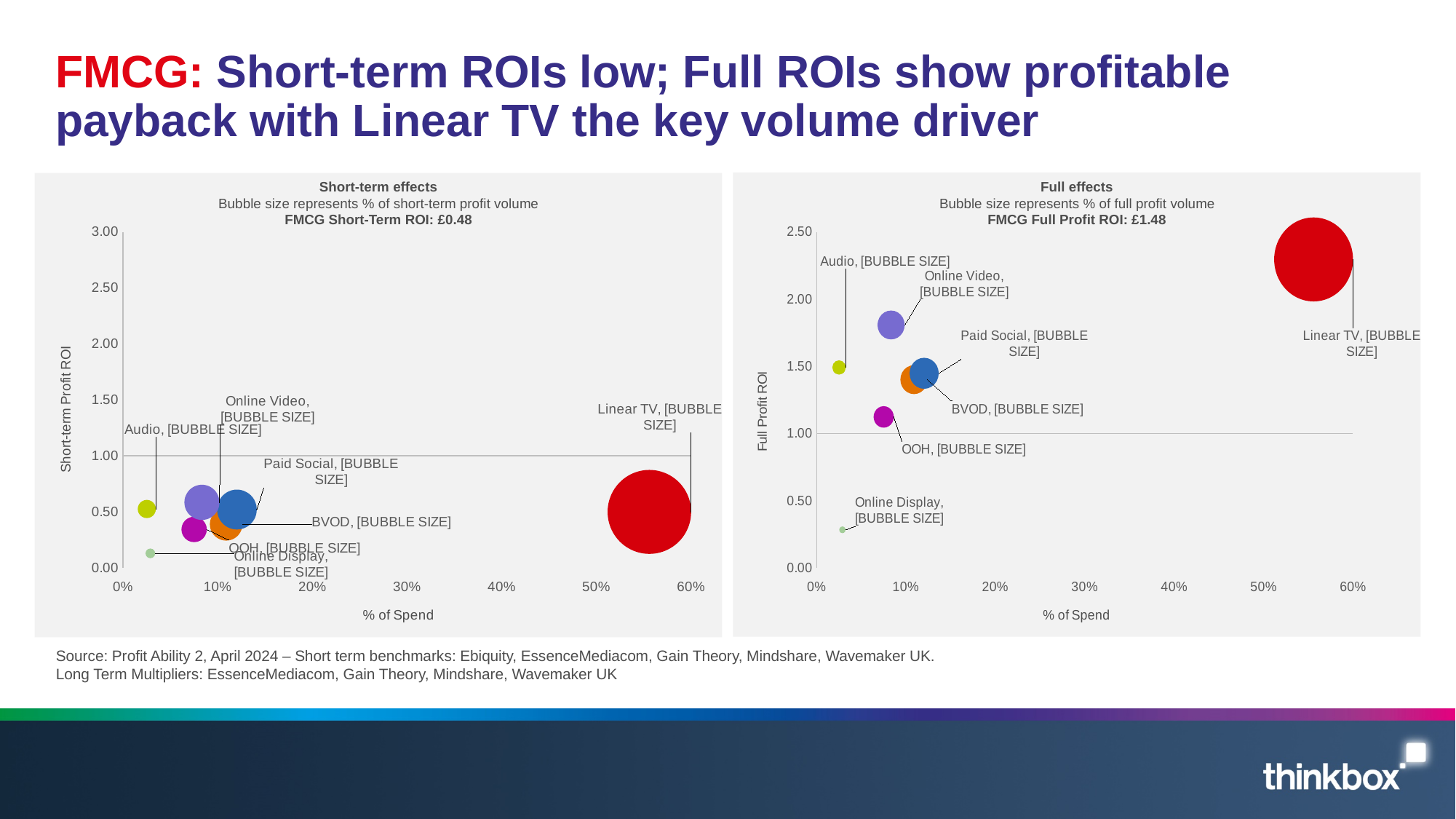
In the 'Short-term effects' chart, is the Short-term Profit ROI for Linear TV greater or less than 1.00? less In the 'Short-term effects' chart, which channel has the lowest Short-term Profit ROI? Online Display In the 'Full effects' chart, which channel has the highest Full Profit ROI? Linear TV What FMCG Full Profit ROI figure is stated in the title of the 'Full effects' chart? £1.48 In the 'Full effects' chart, which channel has the largest % of Spend? Linear TV In the 'Short-term effects' chart, how many bubbles (media channels) are plotted? 7 What kind of chart is the 'Short-term effects' chart? Bubble chart In the 'Full effects' chart, is the Full Profit ROI for Linear TV greater or less than 2.00? greater What FMCG Short-Term ROI figure is stated in the title of the 'Short-term effects' chart? £0.48 In the 'Full effects' chart, which has the higher Full Profit ROI, Online Video or OOH? Online Video In the 'Full effects' chart, is the Full Profit ROI for Online Display greater or less than 0.50? less